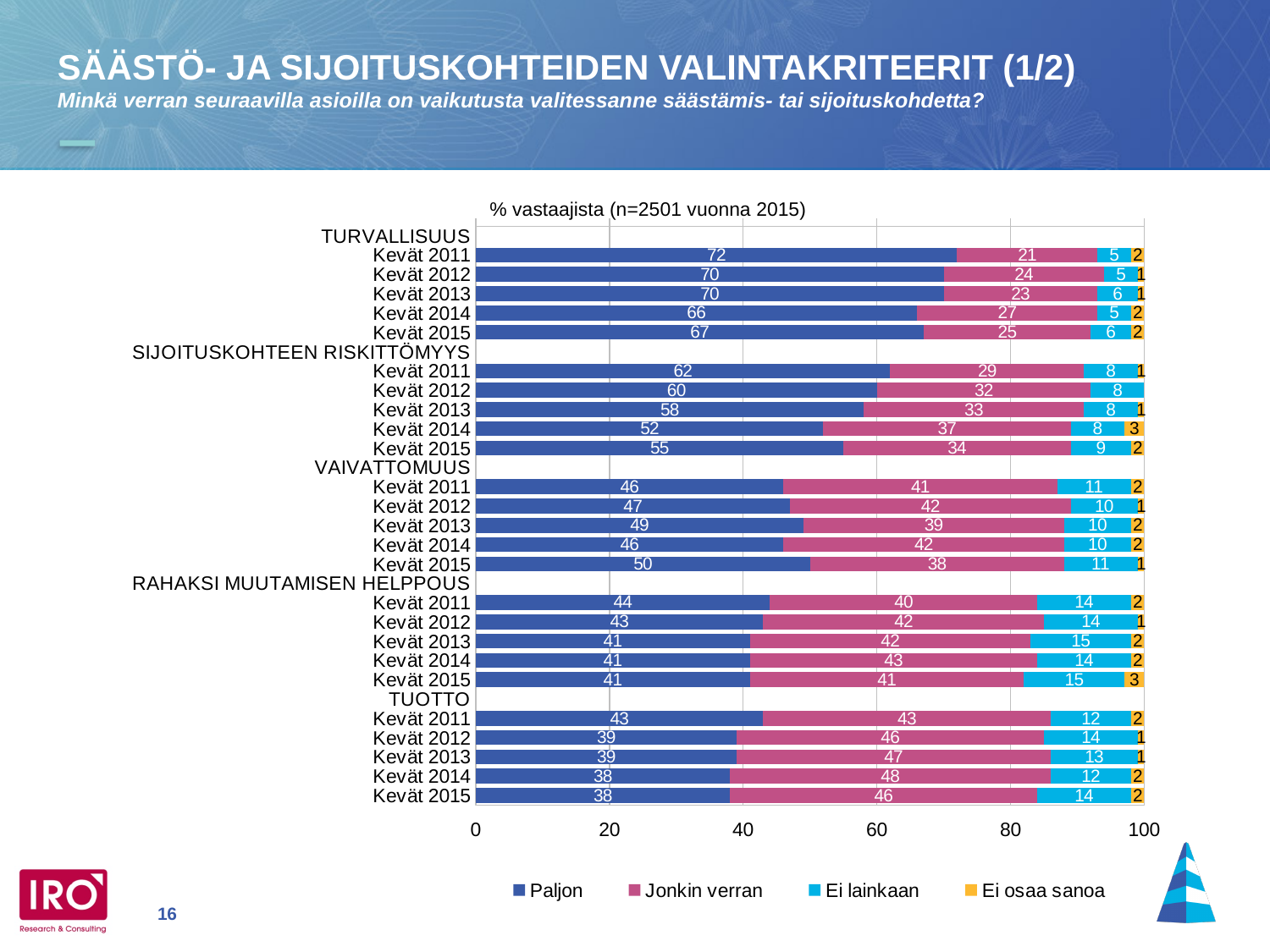
How many series does the legend list? 4 What is the 'Ei lainkaan' value for RAHAKSI MUUTTAMISEN HELPPOUS, Kevät 2015? 15 Which bar has the highest 'Paljon' value in the chart? TURVALLISUUS, Kevät 2011 What kind of chart is shown on the slide? Stacked bar chart What is the 'Jonkin verran' value for TUOTTO, Kevät 2014? 48 What is the total of the stacked bar for TURVALLISUUS, Kevät 2011? 100 Within the TURVALLISUUS group, which year has the lowest 'Paljon' value? Kevät 2014 What is the 'Paljon' value for TURVALLISUUS, Kevät 2011? 72 Which is larger: the 'Paljon' value for VAIVATTOMUUS Kevät 2015 or for VAIVATTOMUUS Kevät 2011? Kevät 2015 How does the 'Paljon' value for TUOTTO change from Kevät 2011 to Kevät 2015? It falls (from 43 to 38) What is the name of the series shown in yellow in the legend? Ei osaa sanoa What is the difference between the 'Paljon' values for SIJOITUSKOHTEEN RISKITTÖMYYS in Kevät 2011 and Kevät 2015? 7